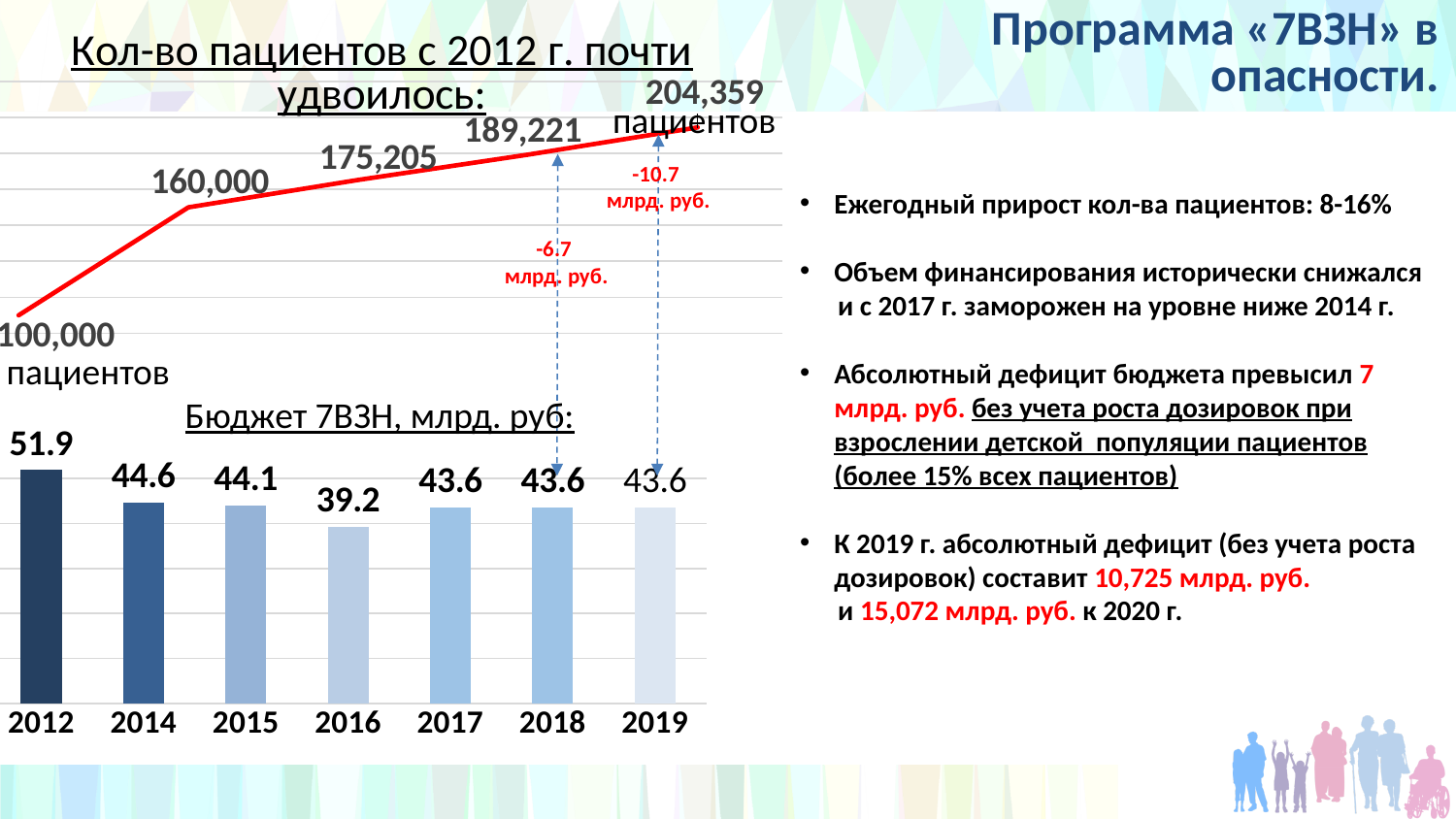
On the line chart 'Кол-во пациентов с 2012 г. почти удвоилось', what is the last (rightmost) labeled value? 204,359 On the bar chart 'Бюджет 7ВЗН, млрд. руб.', which is larger, the value for 2015 or the value for 2016? 2015 On the bar chart 'Бюджет 7ВЗН, млрд. руб.', what is the value for 2016? 39.2 On the bar chart 'Бюджет 7ВЗН, млрд. руб.', what is the difference between the values for 2012 and 2014? 7.3 What kind of chart is 'Бюджет 7ВЗН, млрд. руб.'? Bar chart On the line chart 'Кол-во пациентов с 2012 г. почти удвоилось', what is the first (leftmost) labeled value? 100,000 On the line chart 'Кол-во пациентов с 2012 г. почти удвоилось', what is the difference between the highest and lowest labeled values? 104,359 On the bar chart 'Бюджет 7ВЗН, млрд. руб.', which year has the highest value? 2012 On the line chart 'Кол-во пациентов с 2012 г. почти удвоилось', do the values rise or fall from left to right? Rise On the bar chart 'Бюджет 7ВЗН, млрд. руб.', what is the value for 2012? 51.9 How many bars are shown on the bar chart 'Бюджет 7ВЗН, млрд. руб.'? 7 On the bar chart 'Бюджет 7ВЗН, млрд. руб.', which year has the lowest value? 2016